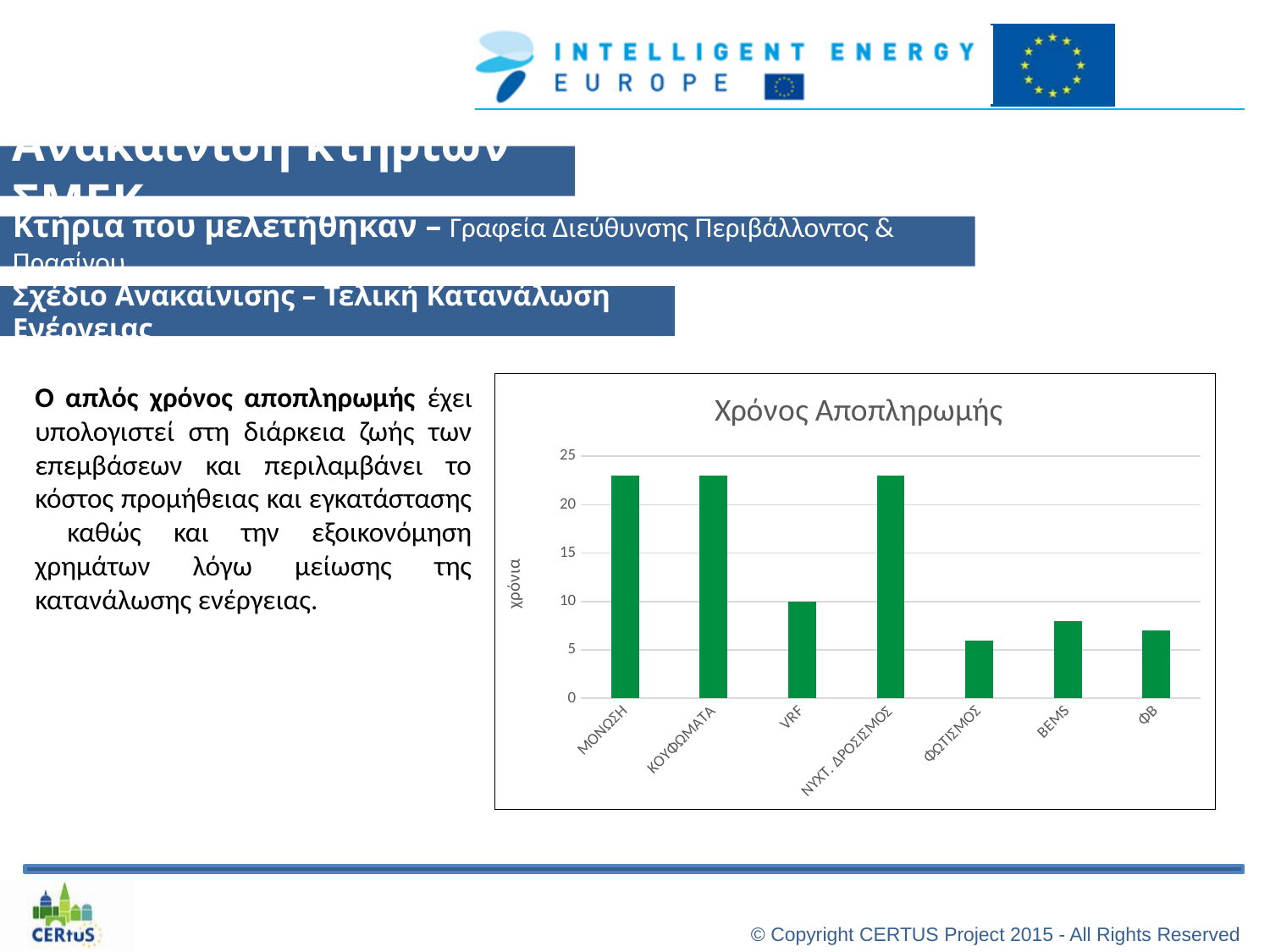
Is the value for BEMS greater or less than 5? greater How many categories are shown on the x axis of the chart? 7 Which has a larger value, ΜΟΝΩΣΗ or VRF? ΜΟΝΩΣΗ Is the value for ΝΥΧΤ. ΔΡΟΣΙΣΜΟΣ greater or less than 25? less Is the value for ΚΟΥΦΩΜΑΤΑ greater or less than 20? greater What is the label on the vertical axis of the chart? χρόνια Which has a larger value, ΦΒ or ΚΟΥΦΩΜΑΤΑ? ΚΟΥΦΩΜΑΤΑ What type of chart is shown on the slide? bar chart What is the value for VRF in the chart? 10 What is the title of the chart? Χρόνος Αποπληρωμής